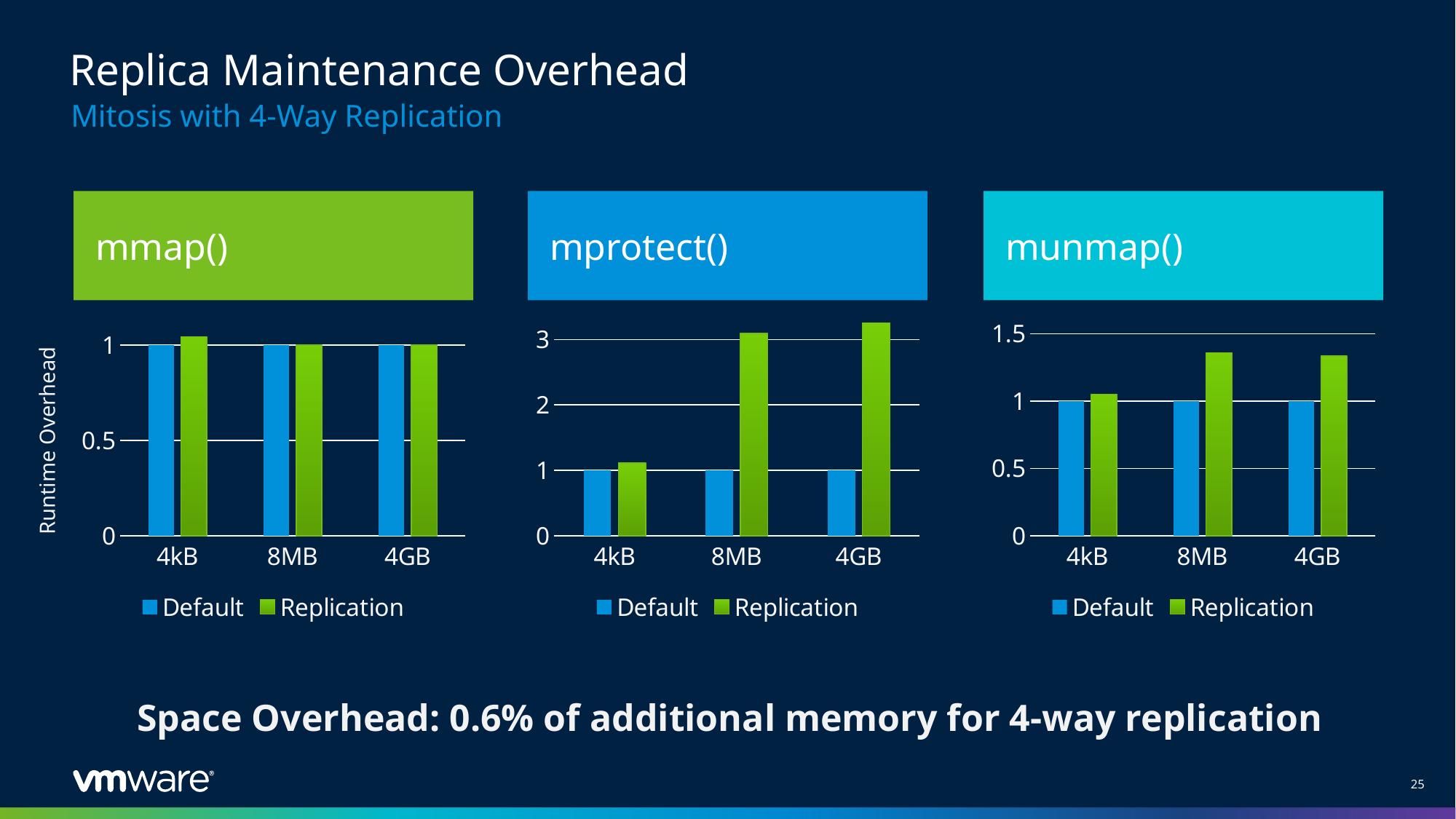
In the mprotect() chart, which is larger for 8MB, the Default bar or the Replication bar? Replication What kind of chart is the mprotect() chart? bar chart How many categories are shown on the x axis of the munmap() chart? 3 How many series does the legend of the mmap() chart list? 2 In the munmap() chart, is the Replication value for 4GB greater or less than 1? greater What is the label on the y axis of the mmap() chart? Runtime Overhead In the mprotect() chart, which category has the lowest Replication value? 4kB In the munmap() chart, what is the value of the Default bar for 8MB? 1 In the mprotect() chart, do the Replication values rise or fall from 4kB to 4GB? rise In the mprotect() chart, what is the value of the Default bar for 4kB? 1 In the mprotect() chart, is the Replication value for 4kB greater or less than 2? less In the mprotect() chart, is the Replication value for 8MB greater or less than 2? greater